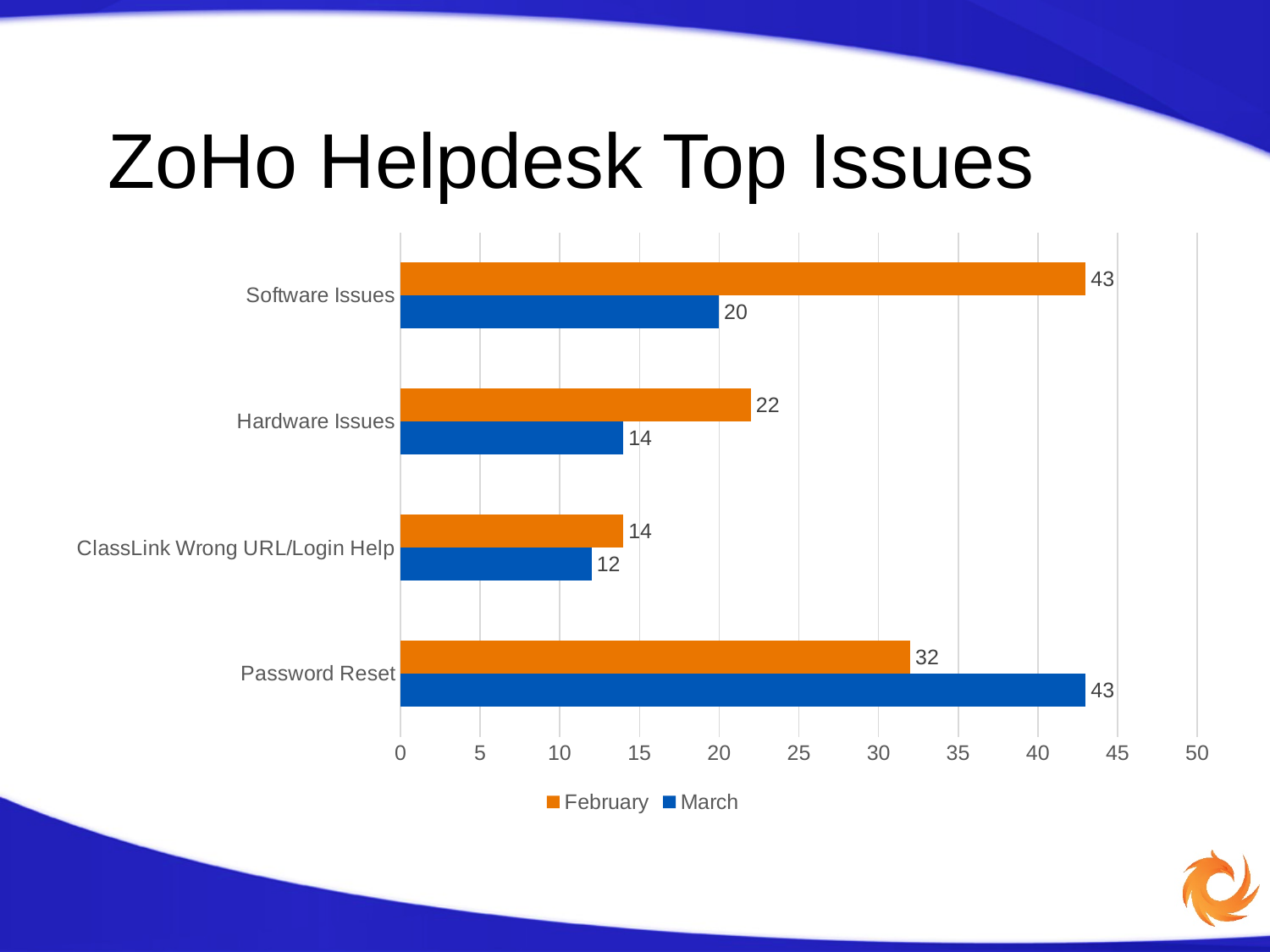
What is the March value for Password Reset? 43 How many series does the legend list? 2 For Password Reset, which month has the larger value, February or March? March What kind of chart is shown on the slide? Bar chart Which category has the highest March value? Password Reset What is the March value for Hardware Issues? 14 How many categories are shown on the chart? 4 Which category has the lowest February value? ClassLink Wrong URL/Login Help What is the February value for ClassLink Wrong URL/Login Help? 14 What is the title of the slide? ZoHo Helpdesk Top Issues What is the difference between the February and March values for Software Issues? 23 What is the February value for Software Issues? 43